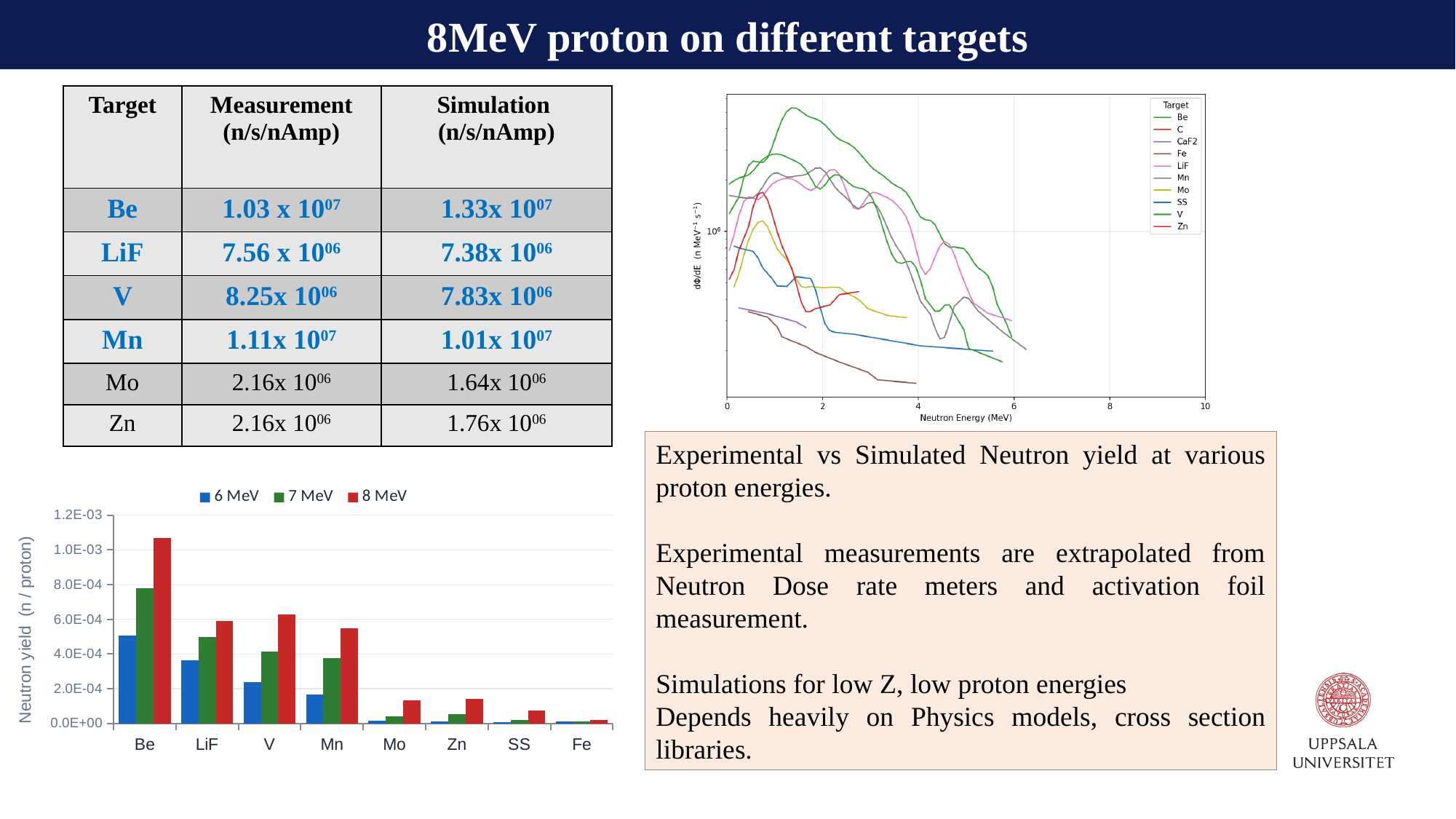
How many target categories are shown on the x axis of the bottom-left bar chart? 8 In the bottom-left bar chart, is the 7 MeV value for Be greater or less than 6.0E-04? greater In the bottom-left bar chart, which is larger for 8 MeV: Be or LiF? Be In the bottom-left bar chart, is the 8 MeV value for Mn greater or less than 4.0E-04? greater In the bottom-left bar chart, which target has the highest 8 MeV neutron yield? Be What is the y-axis label of the bottom-left bar chart? Neutron yield (n / proton) How many targets does the legend of the top-right line chart list? 10 In the bottom-left bar chart, is the 8 MeV value for Be greater or less than 1.0E-03? greater In the bottom-left bar chart, for the Be target, do the values rise or fall going from 6 MeV to 8 MeV? rise What kind of chart is the bottom-left chart with the 6 MeV, 7 MeV and 8 MeV legend? bar chart How many series does the legend of the bottom-left bar chart list? 3